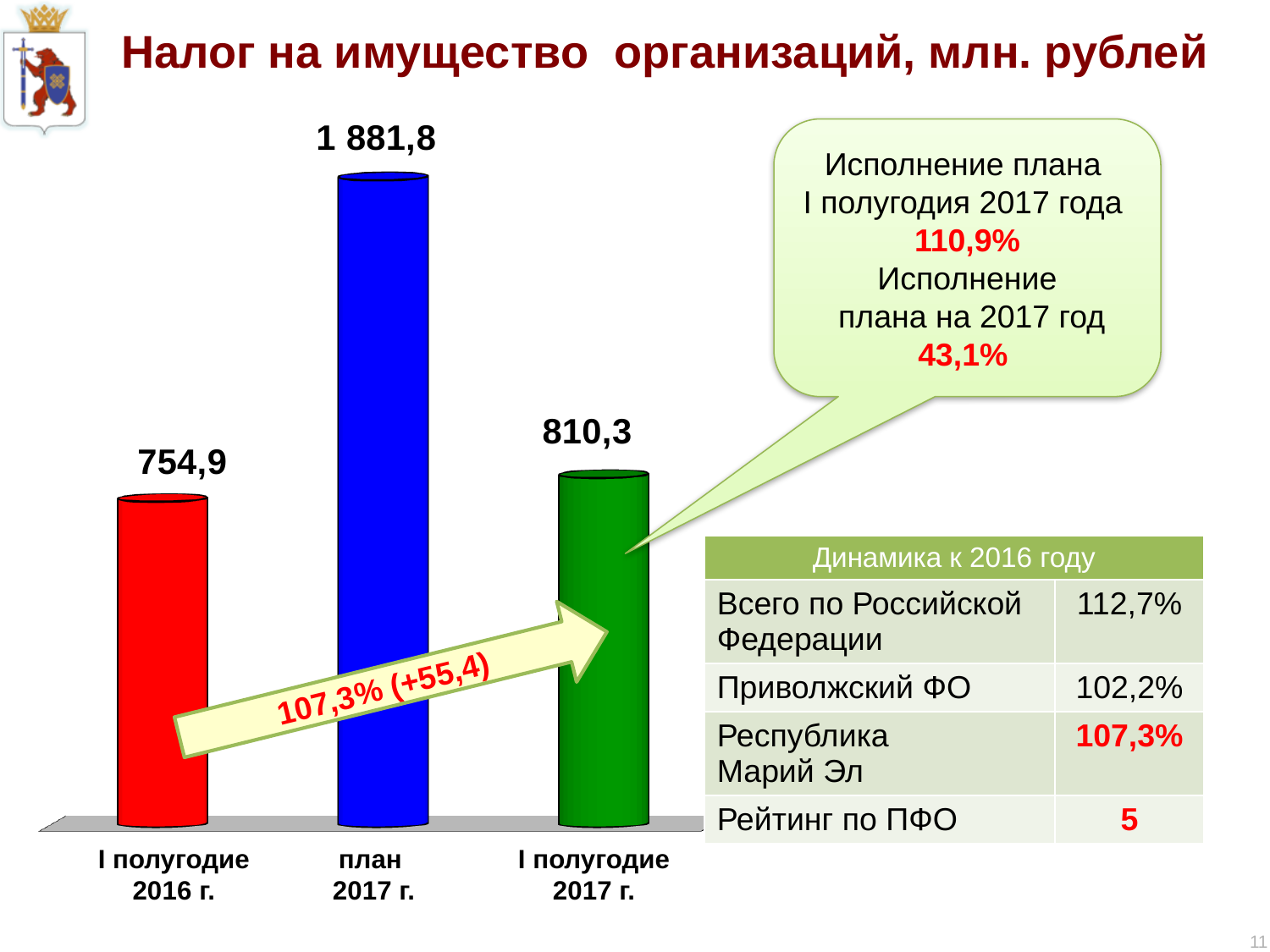
Which category has the highest value? план 2017 г. How many bars are shown in the chart? 3 What is the value for I полугодие 2017 г.? 810,3 What kind of chart is shown on the slide? bar chart What is the difference between the values for I полугодие 2017 г. and I полугодие 2016 г.? 55,4 What colour is the bar for план 2017 г.? blue What is the value for I полугодие 2016 г.? 754,9 Which category has the lowest value? I полугодие 2016 г. Which is larger, the value for I полугодие 2017 г. or the value for I полугодие 2016 г.? I полугодие 2017 г. What is the title of the chart? Налог на имущество организаций, млн. рублей What is the value for план 2017 г.? 1 881,8 What is the difference between the values for план 2017 г. and I полугодие 2017 г.? 1 071,5